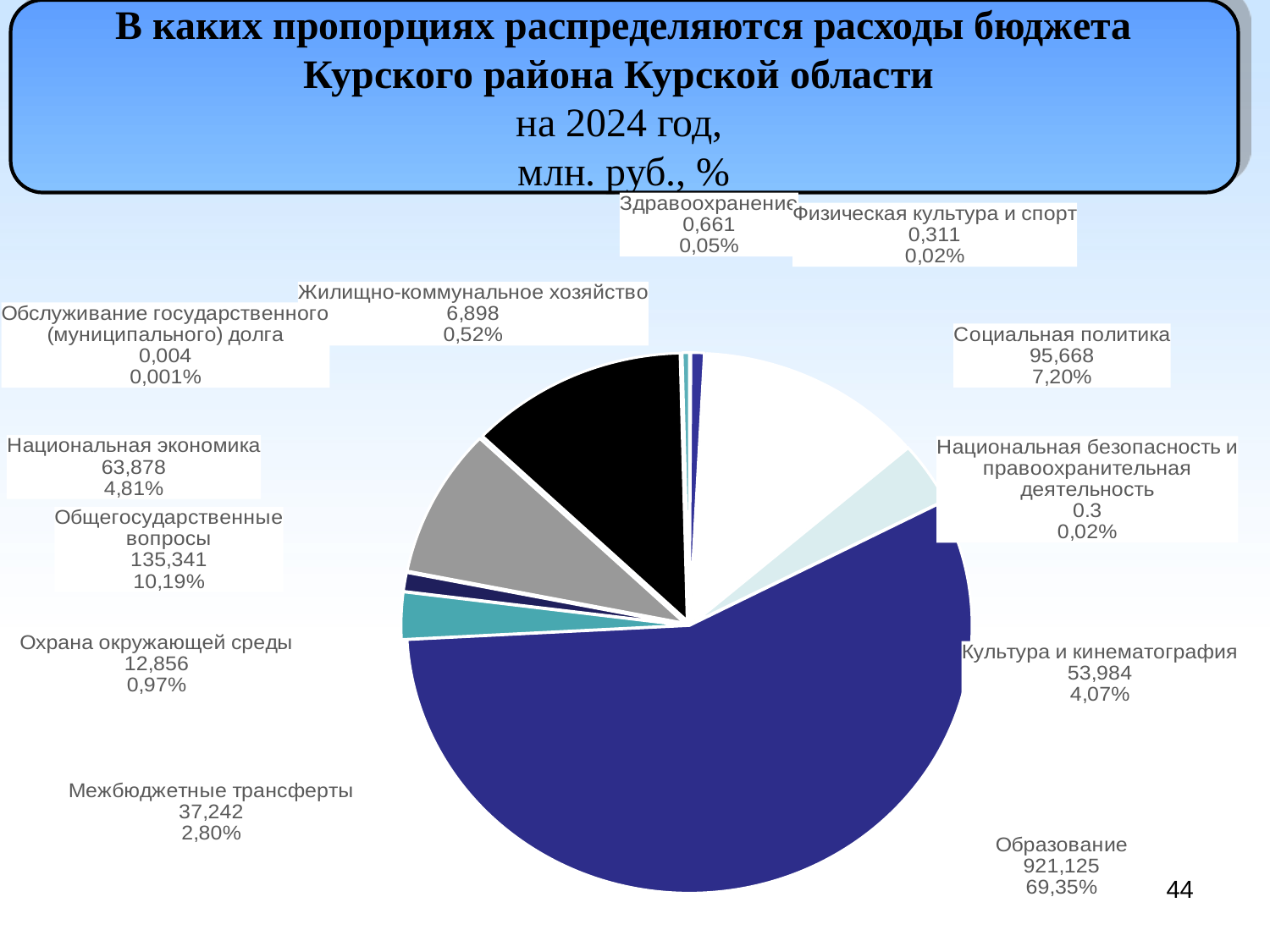
What percentage is shown for Социальная политика? 7,20% What is the value (млн. руб.) for Охрана окружающей среды? 12,856 Which is larger: the value for Национальная экономика or for Культура и кинематография? Национальная экономика Which category has the smallest value? Обслуживание государственного (муниципального) долга What kind of chart is shown on the slide? pie chart What is the difference between the values for Общегосударственные вопросы and Национальная экономика? 71,463 What is the value (млн. руб.) for Образование? 921,125 What is the value (млн. руб.) for Общегосударственные вопросы? 135,341 What percentage is shown for Межбюджетные трансферты? 2,80% What share of the pie does Образование represent? 69,35% How many categories are shown in the pie chart? 12 Which category has the largest slice of the pie? Образование